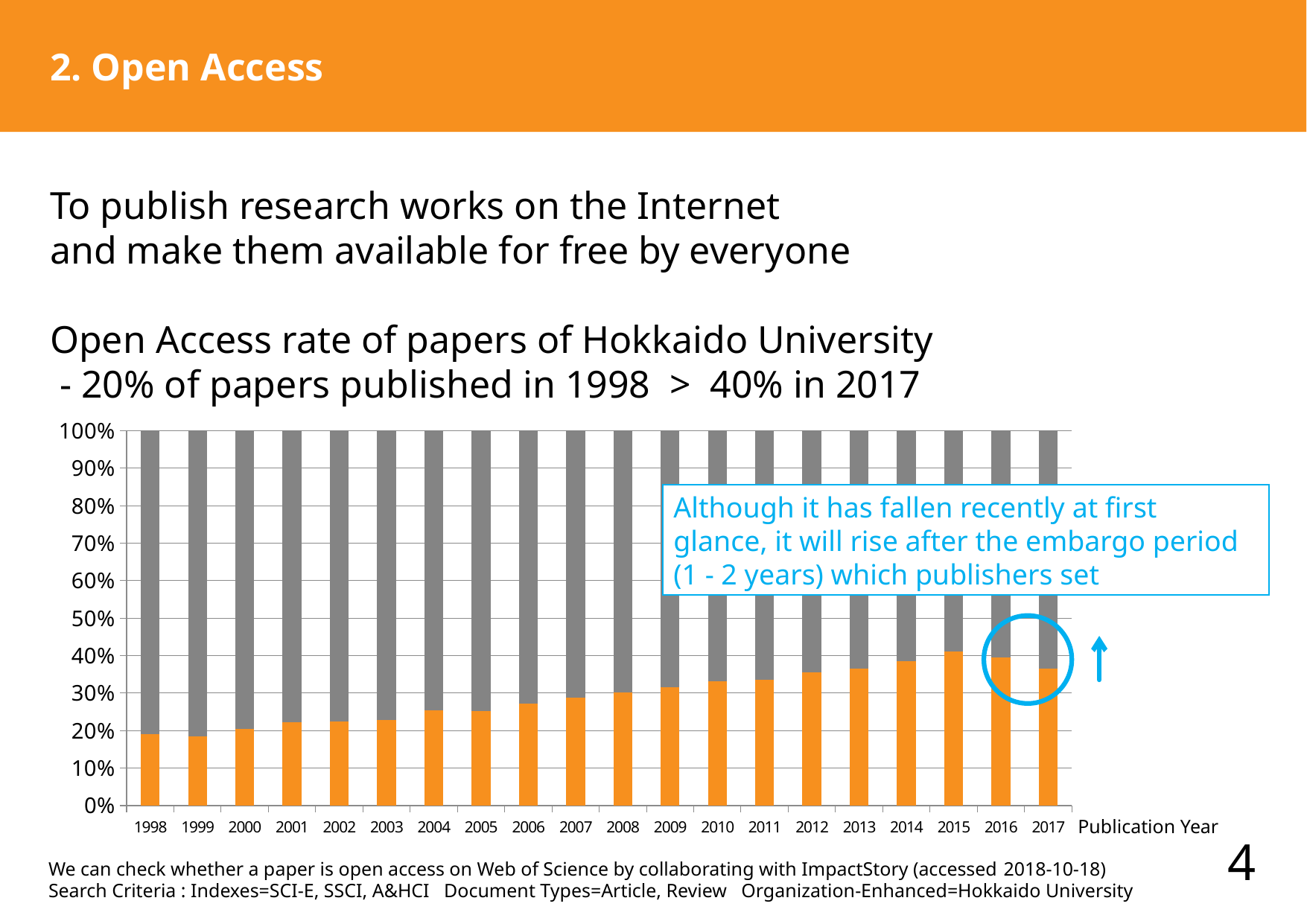
Which year has the larger orange (open access) share, 2015 or 2017? 2015 How many publication years are shown on the x axis of the chart? 20 What is the label of the x axis of the chart? Publication Year What kind of chart is shown on the slide? Stacked bar chart Is the orange (open access) share for 1998 greater or less than 20%? less Is the orange (open access) share for 2004 greater or less than 30%? less Does the orange (open access) share generally rise or fall from 1998 to 2015? rise Is the orange (open access) share for 2015 greater or less than 40%? greater Which year has the larger orange (open access) share, 1998 or 2017? 2017 What is the first publication year shown on the chart's x axis? 1998